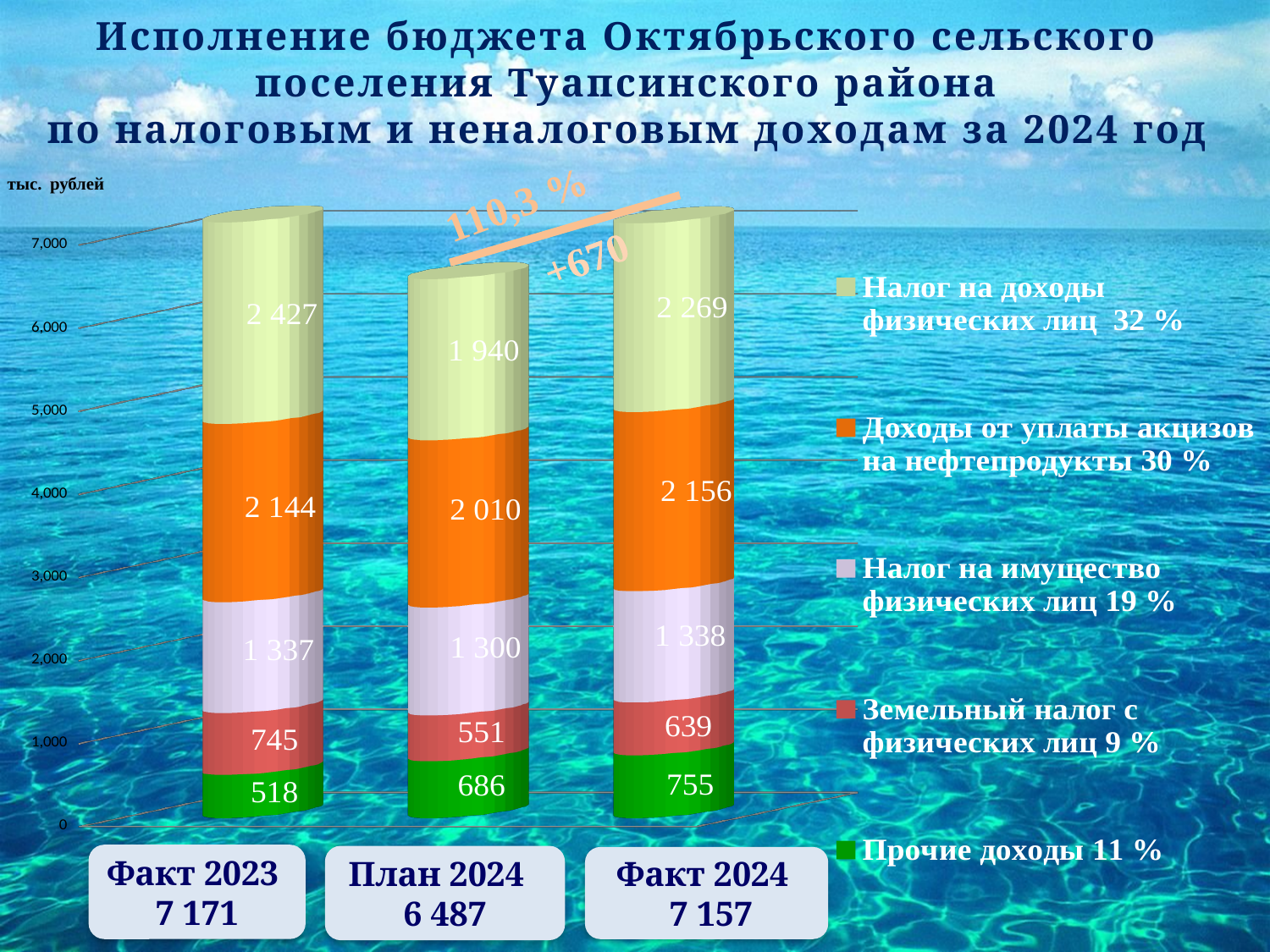
What is the value of Прочие доходы for Факт 2024? 755 What percentage share does the legend give for Налог на имущество физических лиц? 19 % What is the total of the Факт 2024 bar? 7 157 Which bar has the highest total? Факт 2023 Which is larger: Налог на доходы физических лиц for Факт 2023 or for Факт 2024? Факт 2023 How many bars (categories) are plotted in the chart? 3 What is the difference between Земельный налог с физических лиц for Факт 2023 and for План 2024? 194 How many series does the legend list? 5 What is the value of Доходы от уплаты акцизов на нефтепродукты for План 2024? 2 010 What is the value of Налог на доходы физических лиц for Факт 2023? 2 427 What type of chart is shown on the slide? Stacked bar chart Which bar has the lowest total? План 2024